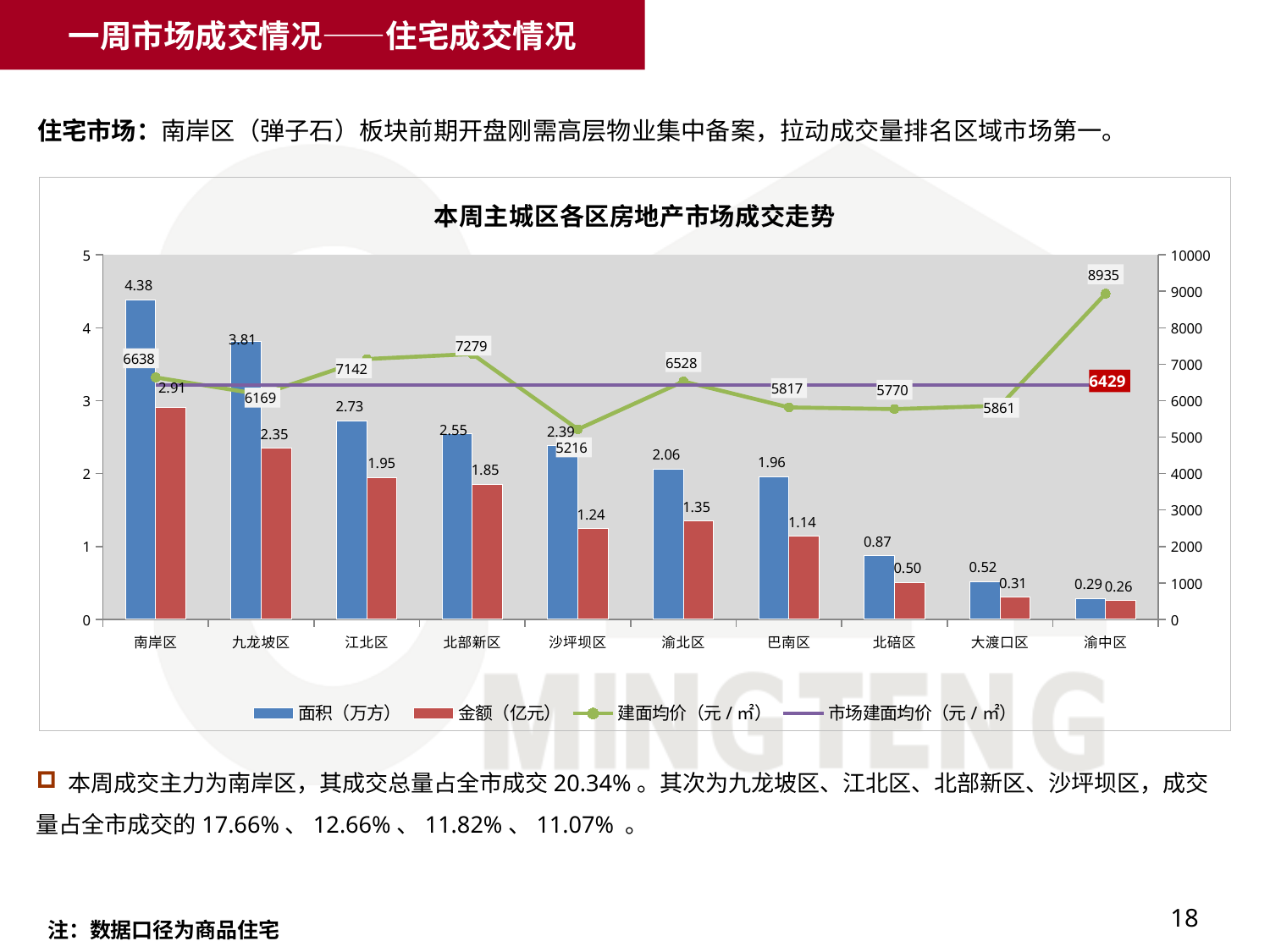
What is the 建面均价（元/㎡） value for 渝中区? 8935 What is the value of the 市场建面均价（元/㎡） line? 6429 How many districts are shown on the x axis? 10 What is the difference between the 面积（万方） values of 南岸区 and 九龙坡区? 0.57 How many series does the legend list? 4 What is the 金额（亿元） value for 江北区? 1.95 What is the 面积（万方） value for 南岸区? 4.38 Do the 面积（万方） values rise or fall from left to right along the x axis? fall What is the title of the chart? 本周主城区各区房地产市场成交走势 Which district has the lowest 建面均价（元/㎡） value? 沙坪坝区 Which district has the highest 面积（万方） value? 南岸区 Which is larger, the 金额（亿元） value for 沙坪坝区 or for 渝北区? 渝北区